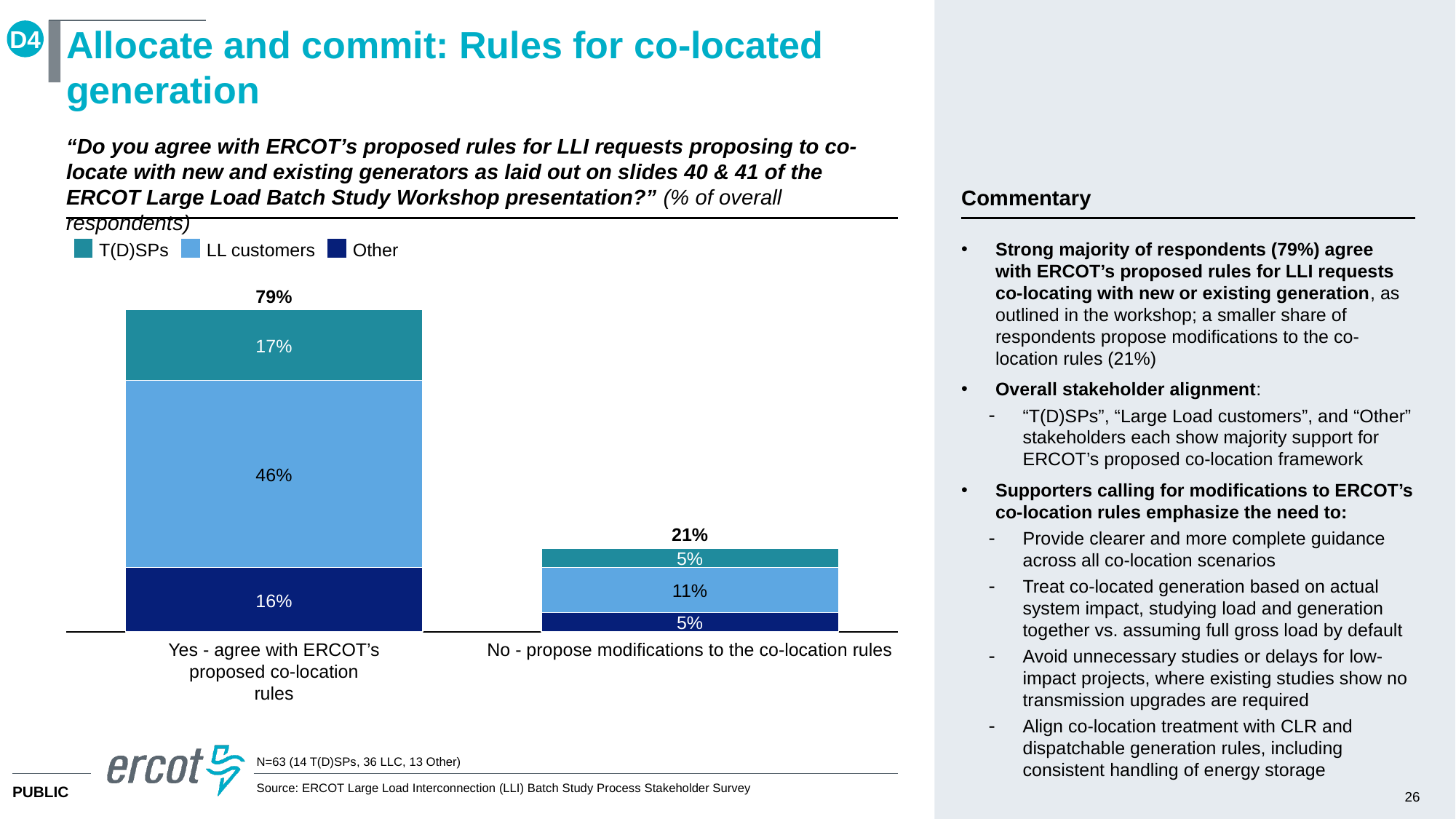
What is the total for the 'Yes - agree with ERCOT's proposed co-location rules' bar? 79% What is the total for the 'No - propose modifications to the co-location rules' bar? 21% What is the value for Other in the 'No - propose modifications to the co-location rules' bar? 5% What is the value for LL customers in the 'Yes - agree with ERCOT's proposed co-location rules' bar? 46% What is the difference between the LL customers values in the 'Yes' bar and the 'No' bar? 35% How many categories are shown on the x axis? 2 Which category has the higher total, 'Yes - agree' or 'No - propose modifications'? Yes - agree with ERCOT's proposed co-location rules What is the value for LL customers in the 'No - propose modifications to the co-location rules' bar? 11% How many series does the legend list? 3 What is the value for T(D)SPs in the 'Yes - agree with ERCOT's proposed co-location rules' bar? 17% What is the difference between the totals of the 'Yes' bar and the 'No' bar? 58% What kind of chart is shown on the slide? Stacked bar chart